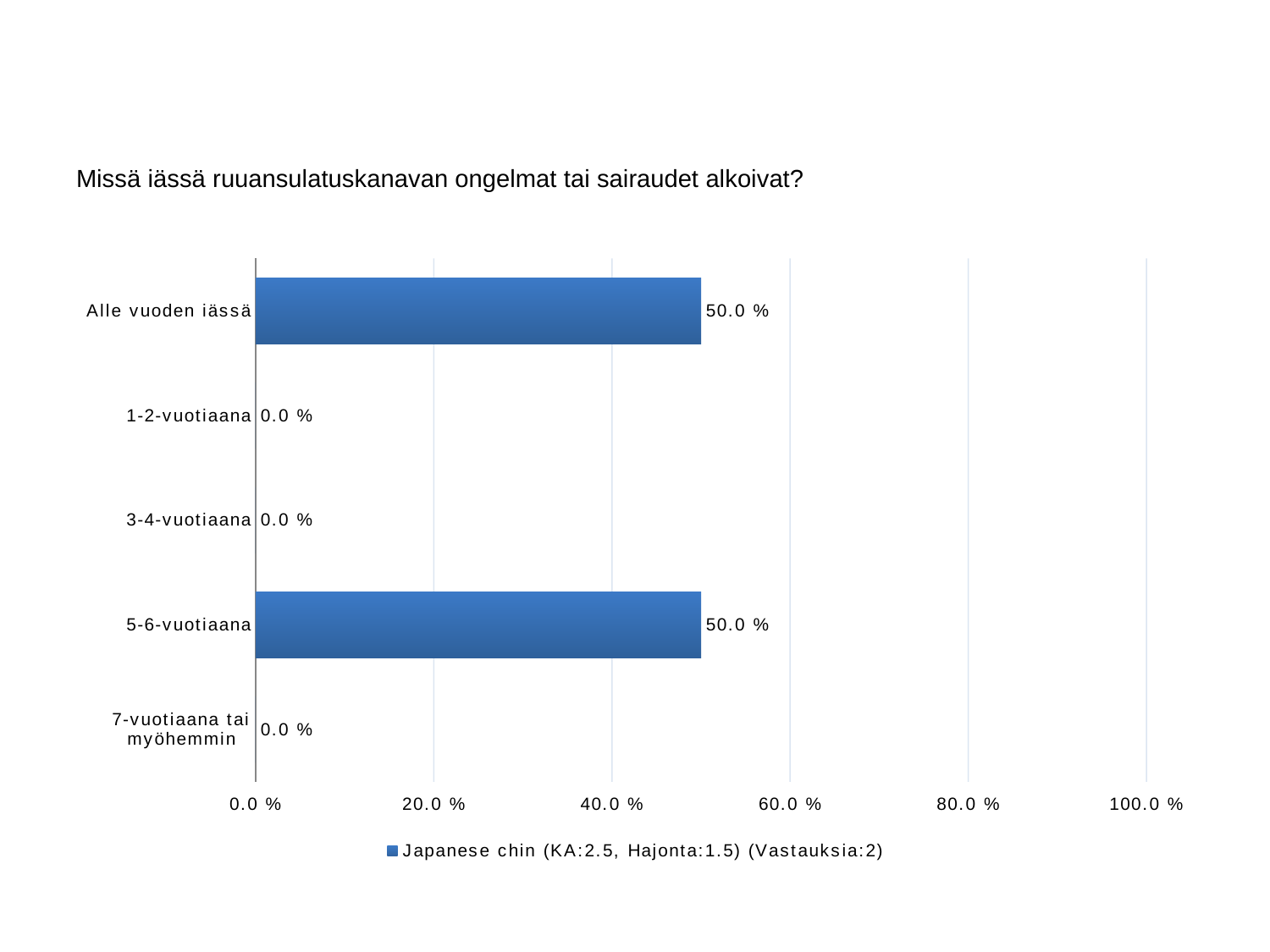
What is the value for "5-6-vuotiaana"? 50.0 % Which is larger, the value for "5-6-vuotiaana" or the value for "1-2-vuotiaana"? 5-6-vuotiaana How many series does the legend list? 1 Which categories share the highest value on the chart? Alle vuoden iässä and 5-6-vuotiaana What is the value for "Alle vuoden iässä"? 50.0 % What is the title of the chart? Missä iässä ruuansulatuskanavan ongelmat tai sairaudet alkoivat? Is the value for "Alle vuoden iässä" greater or less than 40.0 %? greater What is the value for "7-vuotiaana tai myöhemmin"? 0.0 % What is the difference between the values for "Alle vuoden iässä" and "3-4-vuotiaana"? 50.0 % What kind of chart is shown on the slide? Bar chart What is the value for "1-2-vuotiaana"? 0.0 % How many categories are shown on the chart? 5